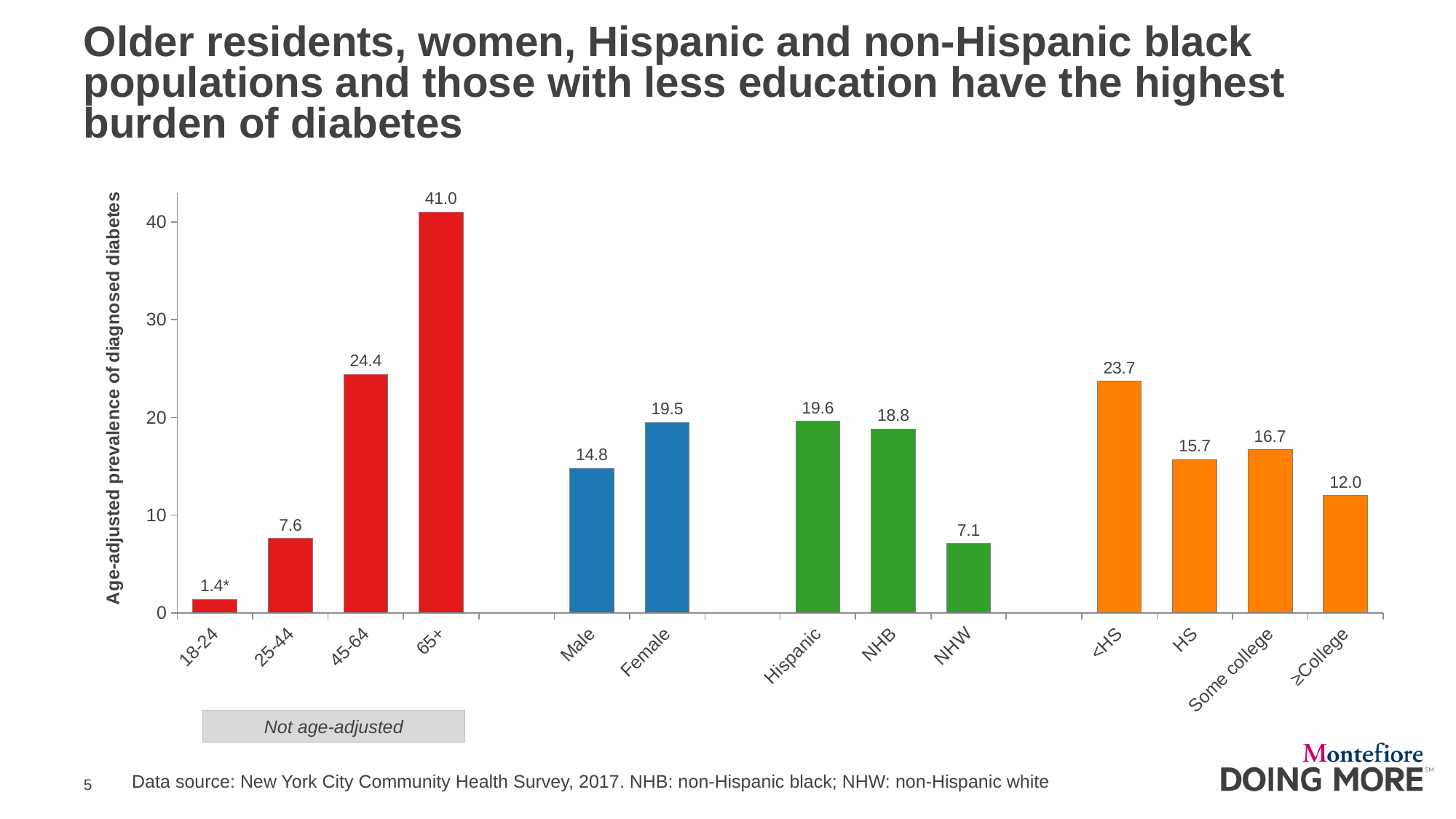
What is the value for NHW? 7.1 What is the difference between the values for Female and Male? 4.7 What is the value for Some college? 16.7 What is the difference between the values for <HS and ≥College? 11.7 What is the value for Female? 19.5 Which category has the highest value? 65+ Which category has the lowest value? 18-24 What is the value for the 65+ age group? 41.0 Is the value for 45-64 greater or less than 20? greater Which is larger, the value for Hispanic or the value for NHW? Hispanic What kind of chart is shown on the slide? Bar chart How many bars are shown in the chart? 13